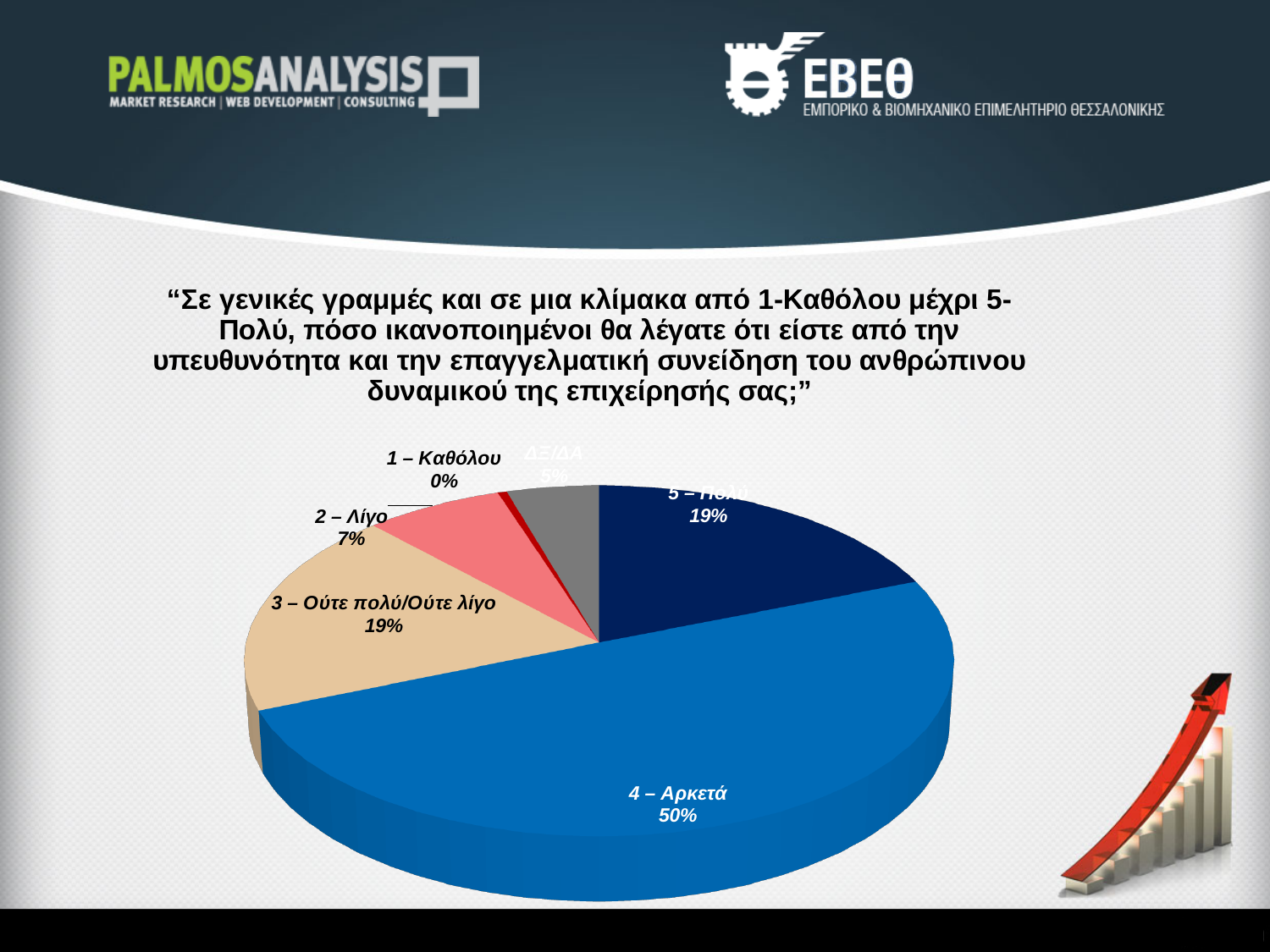
What percentage is shown for "2 – Λίγο"? 7% Which category has the smallest share of the pie? 1 – Καθόλου What percentage is shown for "3 – Ούτε πολύ/Ούτε λίγο"? 19% What share of the pie does the "4 – Αρκετά" slice represent? 50% What colour is the "4 – Αρκετά" slice? blue What is the combined share of "3 – Ούτε πολύ/Ούτε λίγο" and "4 – Αρκετά"? 69% Which is larger, the share for "2 – Λίγο" or the share for "3 – Ούτε πολύ/Ούτε λίγο"? 3 – Ούτε πολύ/Ούτε λίγο How many percentage points larger is "4 – Αρκετά" than "3 – Ούτε πολύ/Ούτε λίγο"? 31 percentage points What percentage is shown for "1 – Καθόλου"? 0% What percentage of respondents answered "4 – Αρκετά"? 50% Which category has the largest slice of the pie? 4 – Αρκετά What kind of chart is shown on the slide? pie chart